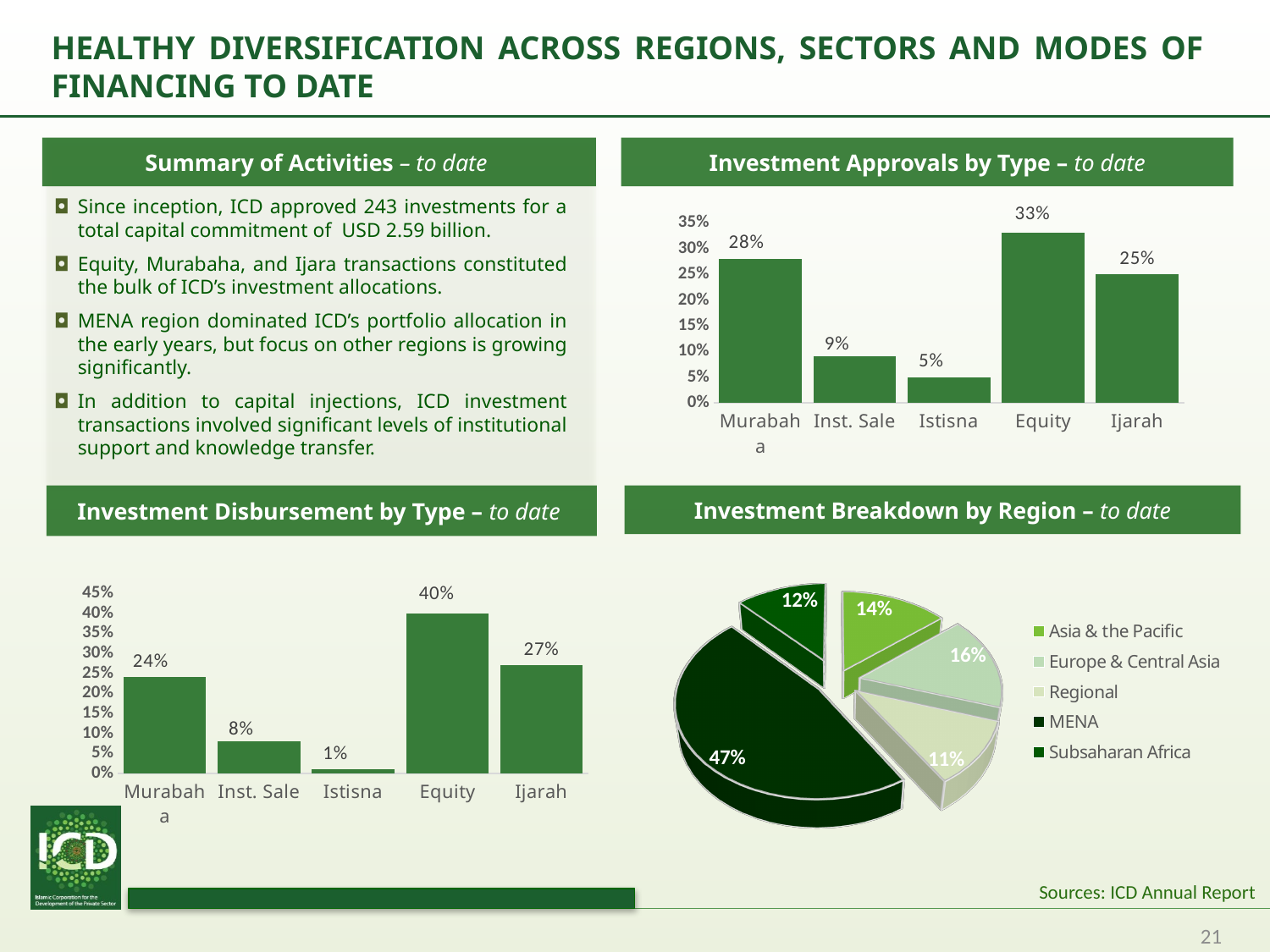
In the Investment Disbursement by Type chart, which type has the highest value? Equity In the Investment Disbursement by Type chart, what is the value for Istisna? 1% What kind of chart is the Investment Breakdown by Region chart? Pie chart In the Investment Approvals by Type chart, which type has the lowest value? Istisna In the Investment Disbursement by Type chart, which is larger, Murabaha or Ijarah? Ijarah What kind of chart is the Investment Disbursement by Type chart? Bar chart In the Investment Breakdown by Region chart, what share does MENA have? 47% In the Investment Approvals by Type chart, what is the value for Equity? 33% In the Investment Approvals by Type chart, how many types are shown? 5 In the Investment Breakdown by Region chart, how many regions does the legend list? 5 In the Investment Disbursement by Type chart, what is the difference between Equity and Ijarah? 13% In the Investment Approvals by Type chart, what is the difference between Murabaha and Ijarah? 3%